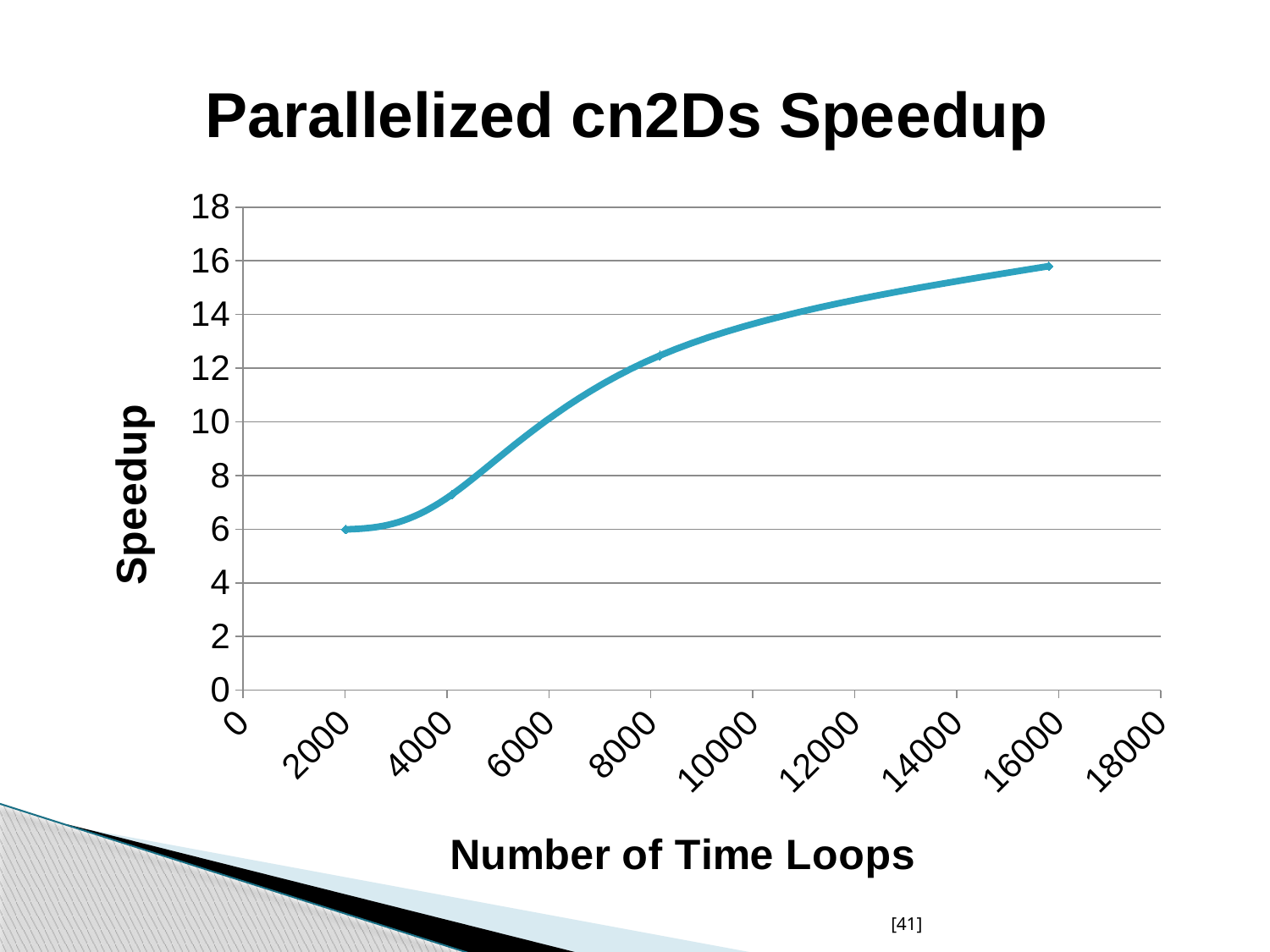
What is the title of the chart? Parallelized cn2Ds Speedup What is the label of the x axis? Number of Time Loops Which has the larger speedup, the leftmost data point or the rightmost data point? the rightmost data point Is the speedup at the rightmost data point greater or less than 16? less How many data points are marked on the line? 4 What kind of chart is shown on the slide? line chart Is the speedup at the rightmost data point greater or less than 14? greater Is the speedup at the leftmost data point greater or less than 8? less Does the speedup rise or fall as the number of time loops increases? rise At which data point is the speedup lowest: the leftmost, middle, or rightmost? the leftmost